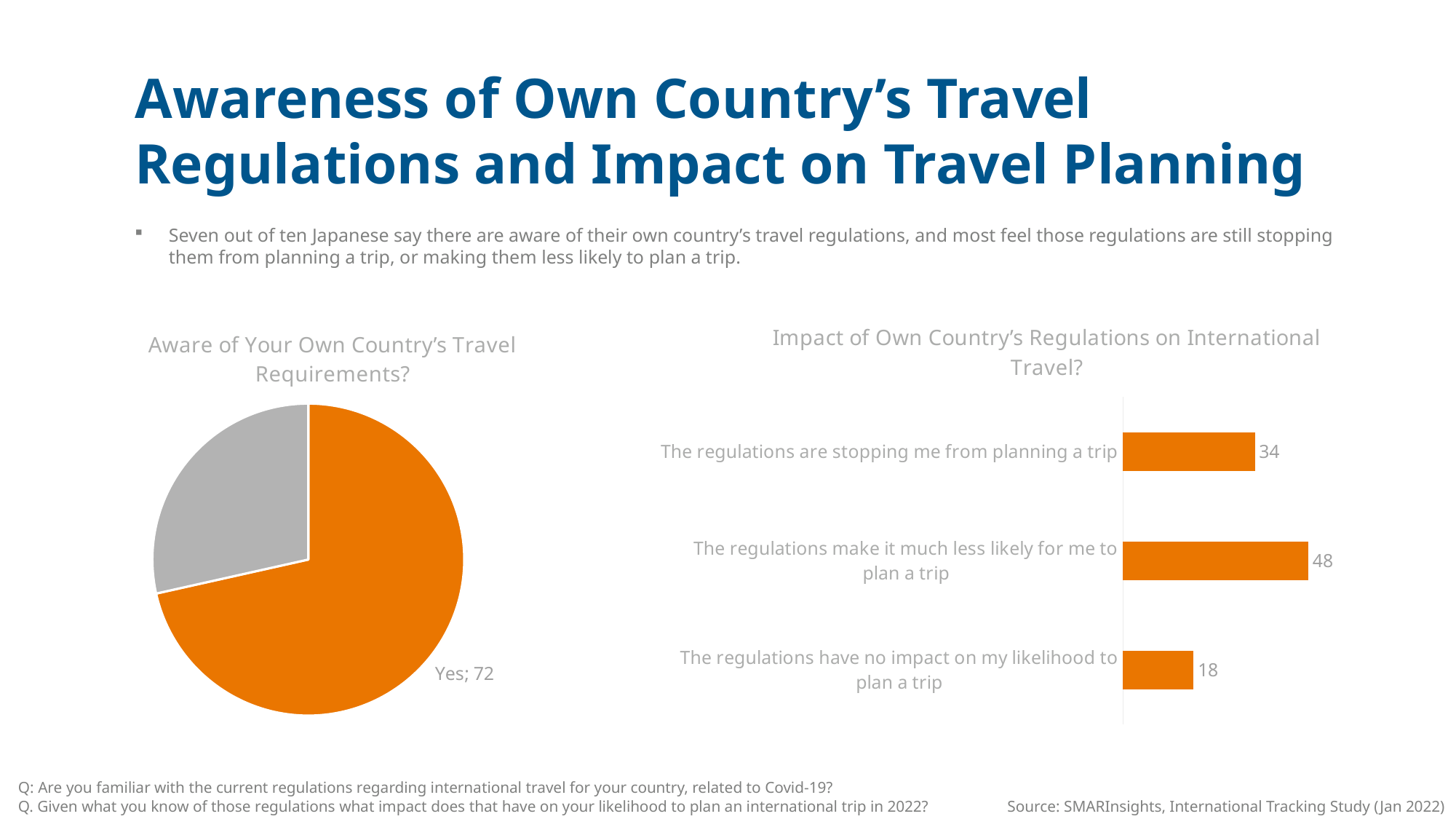
In the 'Impact of Own Country's Regulations on International Travel?' chart, what is the value for 'The regulations are stopping me from planning a trip'? 34 How many categories are shown in the 'Impact of Own Country's Regulations on International Travel?' chart? 3 In the 'Impact of Own Country's Regulations on International Travel?' chart, which category has the lowest value? The regulations have no impact on my likelihood to plan a trip In the 'Impact of Own Country's Regulations on International Travel?' chart, which category has the highest value? The regulations make it much less likely for me to plan a trip In the 'Impact of Own Country's Regulations on International Travel?' chart, what is the difference between 'The regulations make it much less likely for me to plan a trip' and 'The regulations are stopping me from planning a trip'? 14 In the 'Impact of Own Country's Regulations on International Travel?' chart, which is larger: 'The regulations are stopping me from planning a trip' or 'The regulations have no impact on my likelihood to plan a trip'? The regulations are stopping me from planning a trip In the 'Impact of Own Country's Regulations on International Travel?' chart, what is the value for 'The regulations have no impact on my likelihood to plan a trip'? 18 What kind of chart is 'Aware of Your Own Country's Travel Requirements?'? pie chart In the 'Impact of Own Country's Regulations on International Travel?' chart, what is the value for 'The regulations make it much less likely for me to plan a trip'? 48 What is the title of the pie chart on the left of the slide? Aware of Your Own Country's Travel Requirements? In the pie chart 'Aware of Your Own Country's Travel Requirements?', what is the value for Yes? 72 What kind of chart is 'Impact of Own Country's Regulations on International Travel?'? bar chart